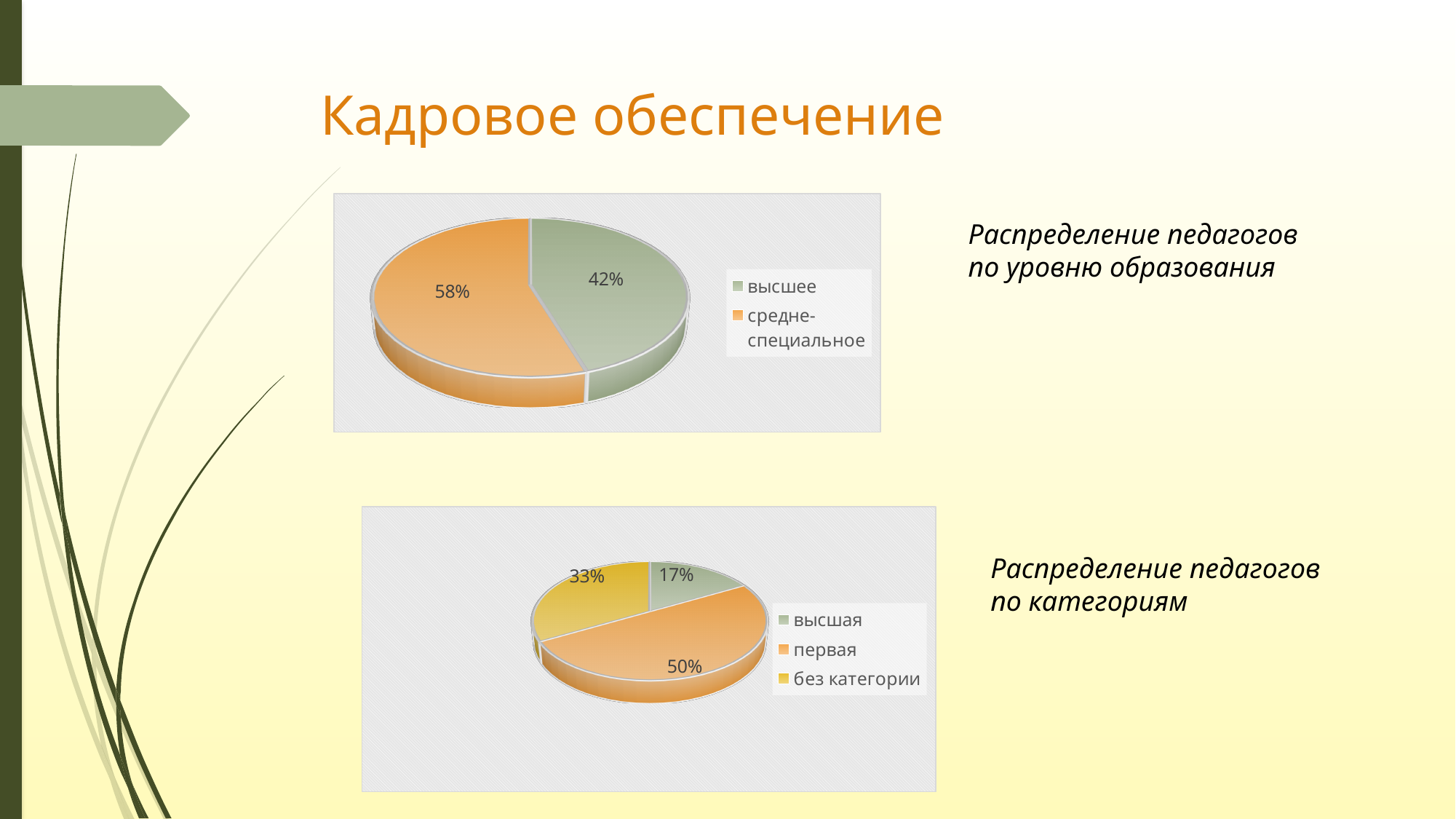
In the top pie chart (distribution of teachers by education level), what share is labelled for "высшее"? 42% In the bottom pie chart, what share is labelled for "без категории"? 33% In the top pie chart, what is the difference between the "средне-специальное" and "высшее" shares? 16% In the bottom pie chart (distribution of teachers by category), what share is labelled for "первая"? 50% What type of chart is the top chart on the slide? Pie chart In the top pie chart, which category has the larger share? средне-специальное In the bottom pie chart, which is larger: the share for "без категории" or the share for "высшая"? без категории In the bottom pie chart, what share is labelled for "высшая"? 17% How many categories does the bottom pie chart show? 3 In the top pie chart, what share is labelled for "средне-специальное"? 58% In the bottom pie chart, which category has the smallest share? высшая How many entries does the legend of the top pie chart list? 2